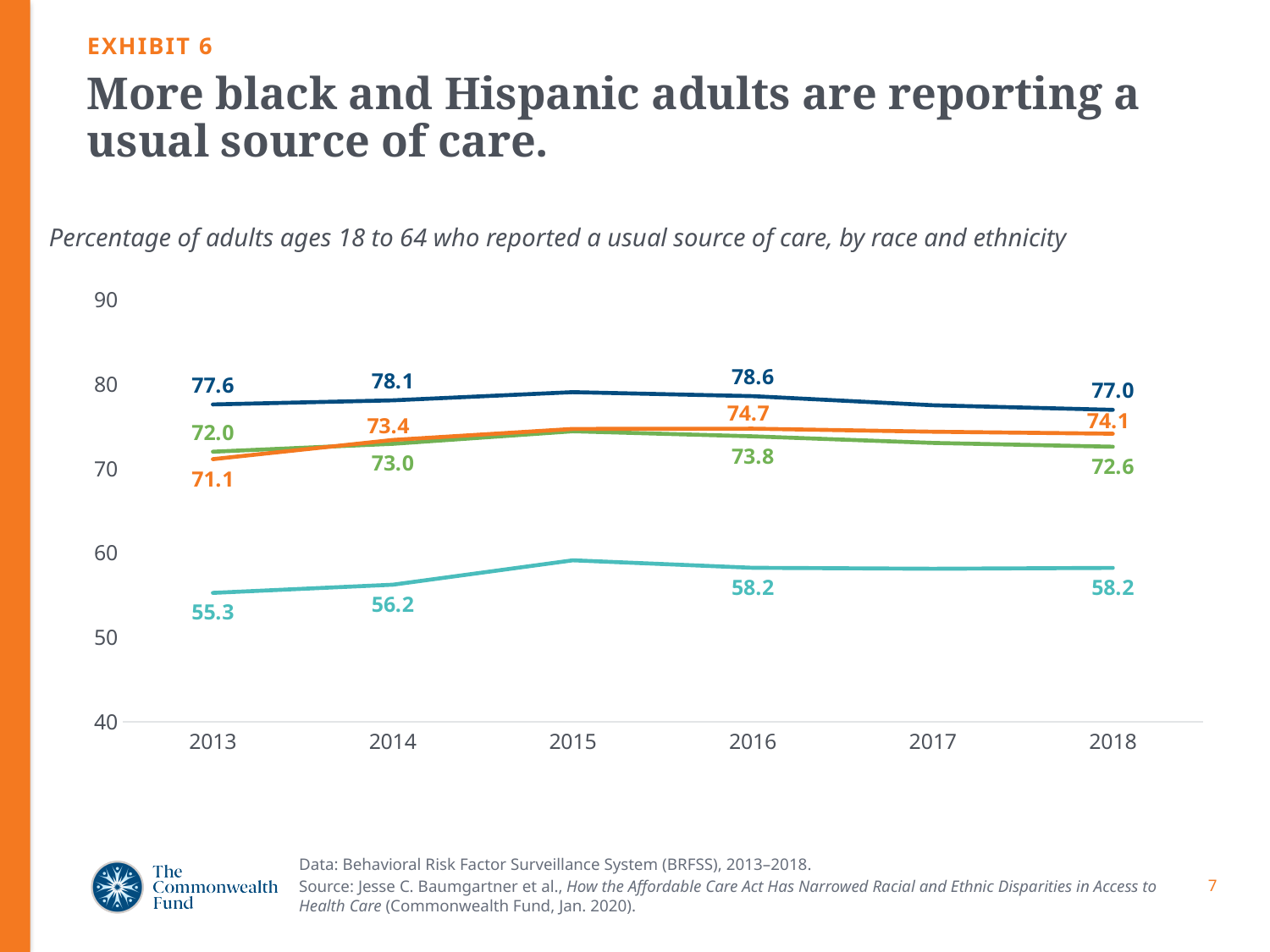
What is the value of the orange line in 2014? 73.4 What is the value of the teal (light blue) line in 2013? 55.3 What is the value of the dark blue line in 2016? 78.6 In which labeled year is the teal line at its lowest value? 2013 What is the difference between the dark blue line and the teal line in 2018? 18.8 What kind of chart is shown on the slide? line chart In 2016, which line has the larger value, the orange line or the green line? orange line Is the value of the teal line in 2017 greater or less than 60? less What is the value of the green line in 2018? 72.6 In which labeled year does the dark blue line reach its highest value? 2016 How many years are shown on the x axis? 6 Does the teal line rise or fall from 2013 to 2018? rise